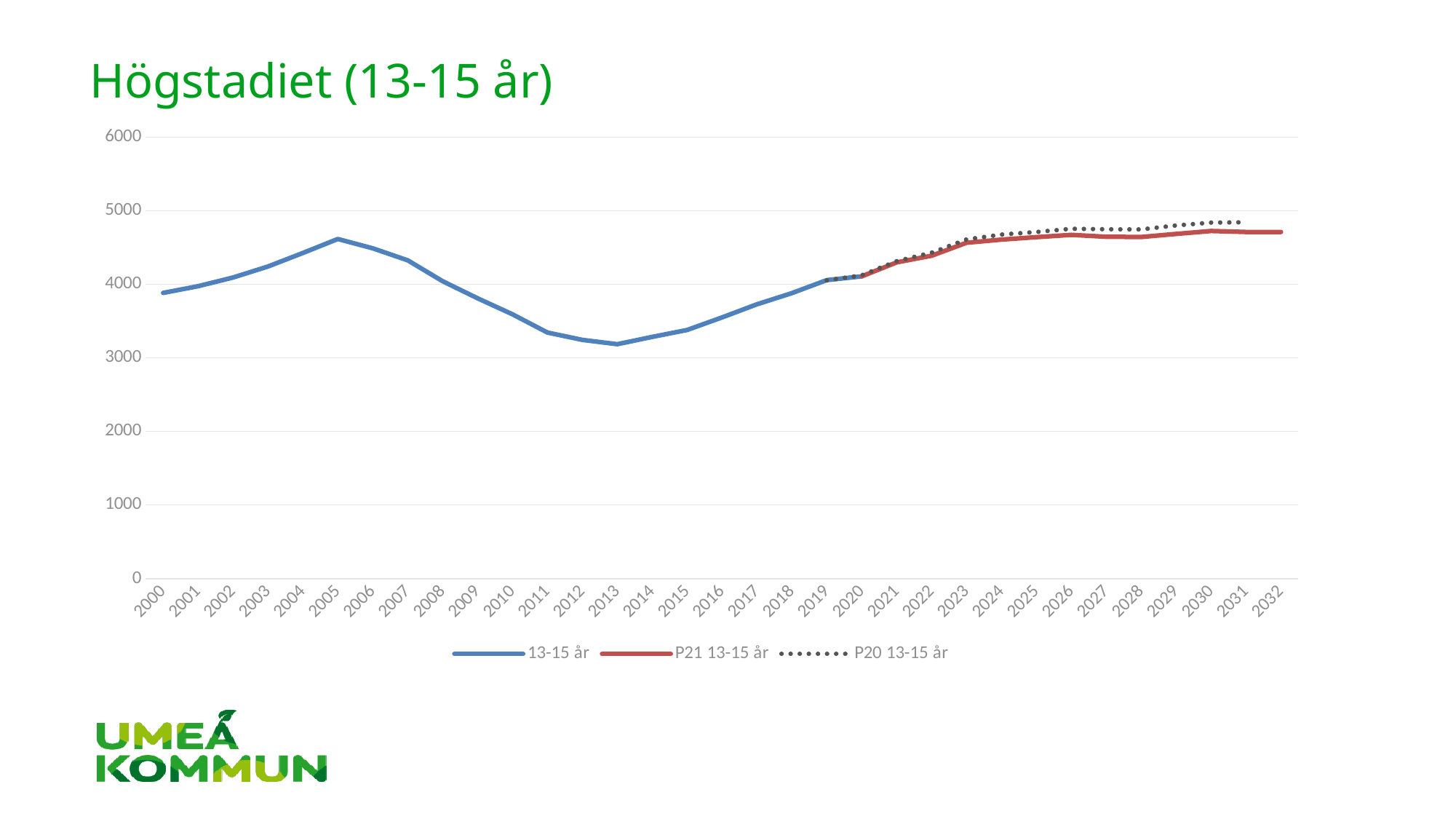
In which year does the 13-15 år series reach its lowest value? 2013 Is the value of the 13-15 år series in 2013 greater or less than 4000? less How many years are shown on the x axis? 33 Is the value of the 13-15 år series in 2005 greater or less than 4000? greater Which series is drawn as a dotted line? P20 13-15 år How many series does the legend list? 3 In which year does the 13-15 år series reach its highest value? 2005 What kind of chart is shown on the slide? line chart Does the 13-15 år series rise or fall between 2005 and 2013? fall Which is larger in 2031, the P20 13-15 år value or the P21 13-15 år value? P20 13-15 år What is the title of the chart? Högstadiet (13-15 år) Is the value of the P21 13-15 år series in 2032 greater or less than 4000? greater